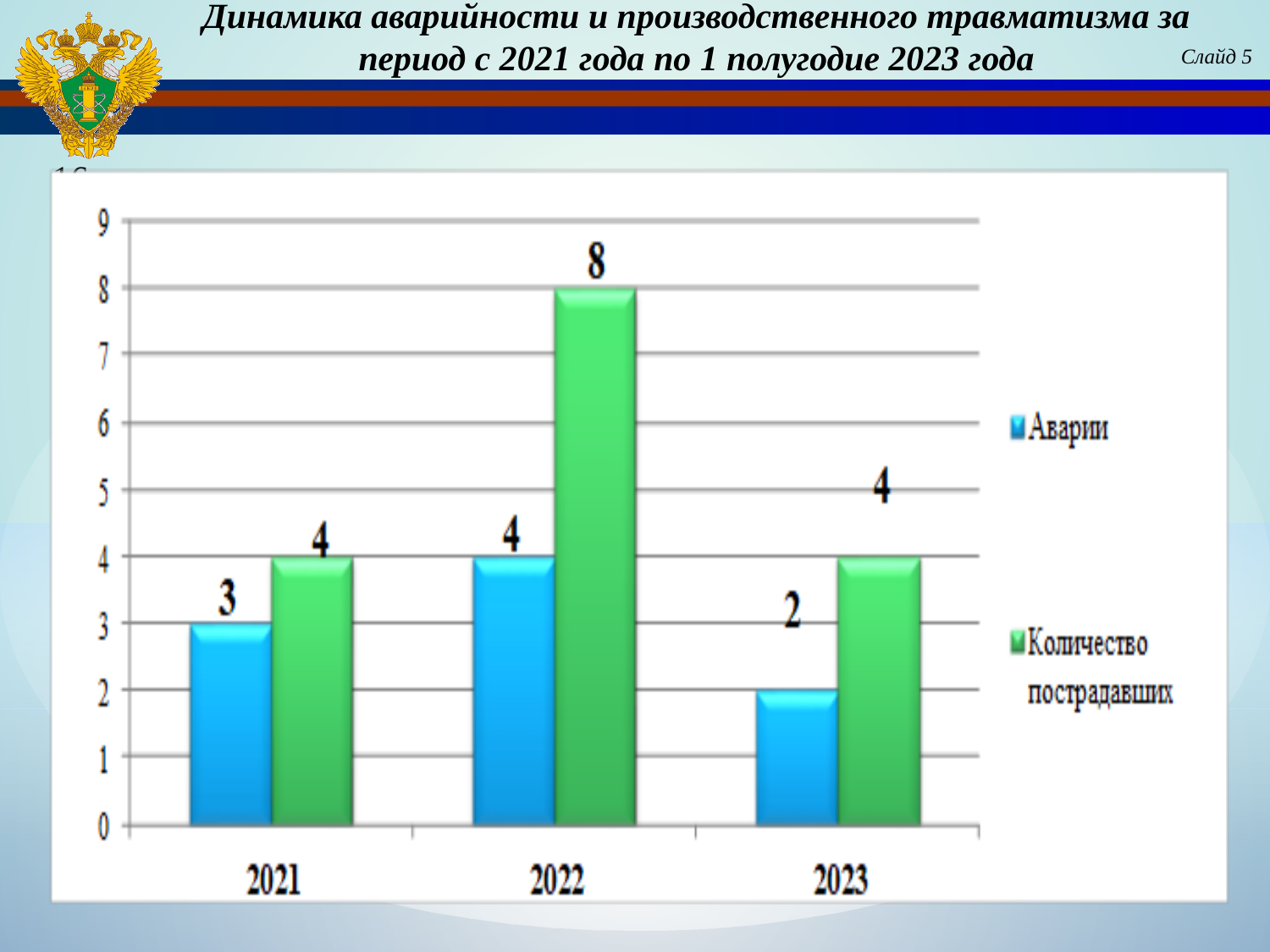
Which colour represents the Аварии series? Blue Which is larger: Аварии in 2022 or Аварии in 2023? Аварии in 2022 In which year is Аварии lowest? 2023 What is the value of Аварии for 2021? 3 What is the value of Аварии for 2023? 2 In which year is Количество пострадавших highest? 2022 What is the value of Количество пострадавших for 2022? 8 Does the value of Аварии rise or fall from 2022 to 2023? Fall How many series does the legend list? 2 What is the difference between Количество пострадавших in 2022 and in 2021? 4 What kind of chart is shown on the slide? Bar chart How many years are shown on the x axis? 3